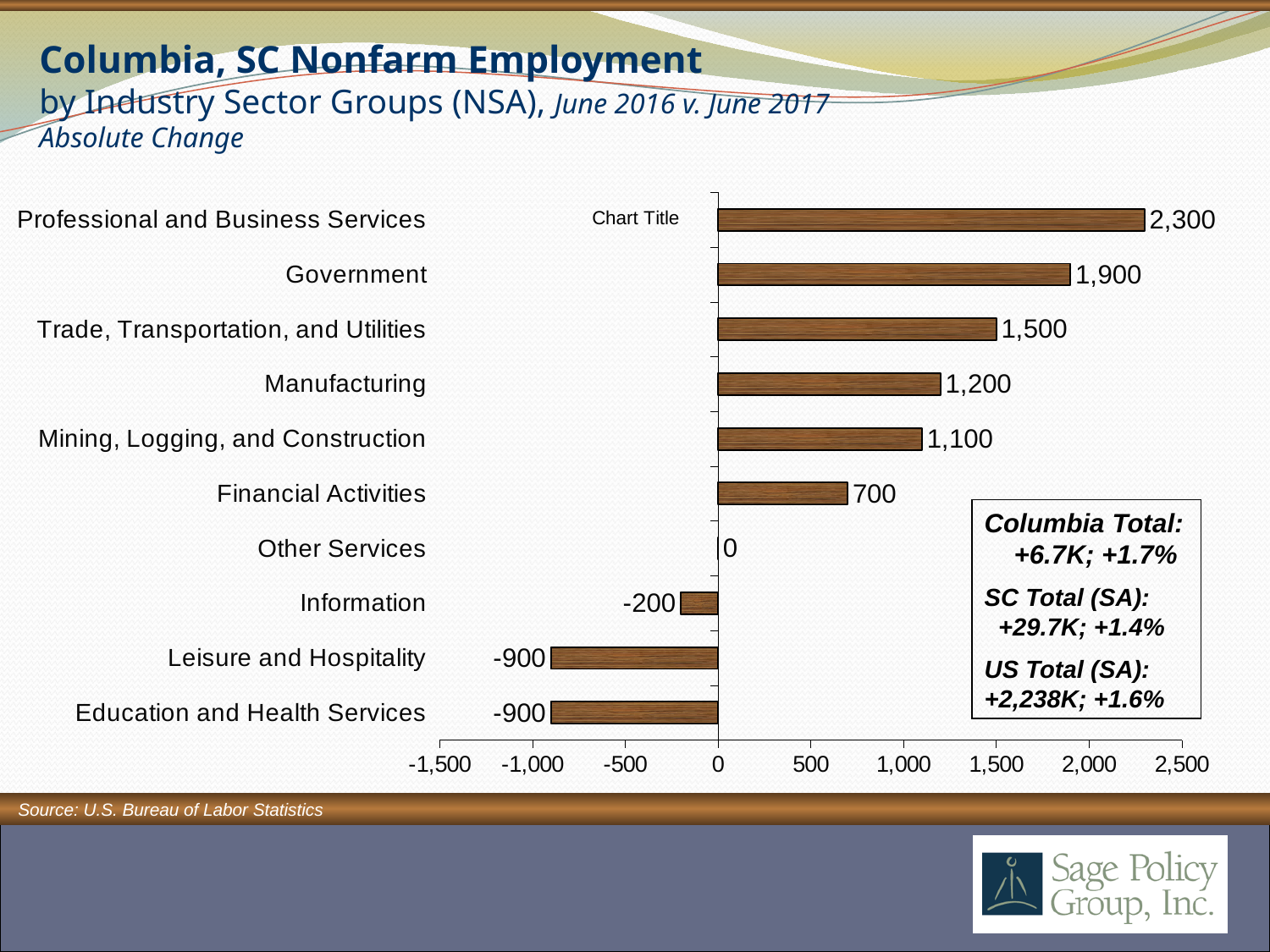
Which is larger, the value for Trade, Transportation, and Utilities or the value for Mining, Logging, and Construction? Trade, Transportation, and Utilities What is the value shown for Other Services? 0 What is the source cited for the chart data? U.S. Bureau of Labor Statistics Which industry sector group has the highest absolute change? Professional and Business Services What is the difference between the values for Manufacturing and Financial Activities? 500 What is the absolute change in employment for Professional and Business Services? 2,300 What is the difference between the values for Professional and Business Services and Government? 400 What is the value shown for Government? 1,900 How many industry sector groups show a negative absolute change? 3 How many industry sector groups are shown in the chart? 10 What kind of chart is shown on the slide? Bar chart What is the value shown for Information? -200